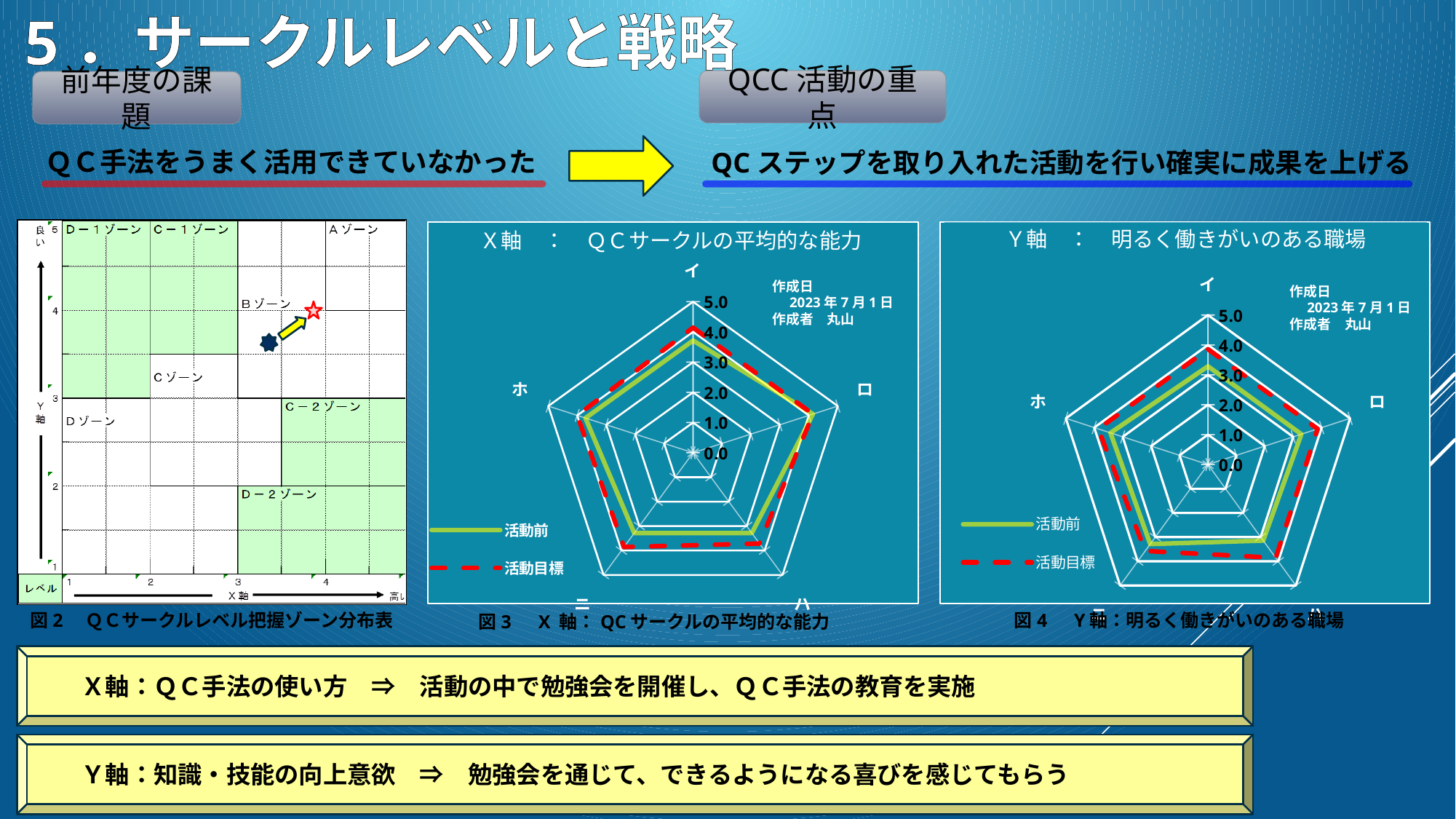
In 図4 (Y軸: 明るく働きがいのある職場), how many series does the legend list? 2 In 図3 (X軸: QCサークルの平均的な能力), is the 活動前 value for イ greater or less than 3.0? greater In 図4 (Y軸: 明るく働きがいのある職場), is the 活動前 value for イ greater or less than 4.0? less In 図4 (Y軸: 明るく働きがいのある職場), which series has the larger value for ハ, 活動前 or 活動目標? 活動目標 In 図3 (X軸: QCサークルの平均的な能力), what are the two series named in the legend? 活動前 and 活動目標 What kind of chart is 図4 (Y軸: 明るく働きがいのある職場)? Radar chart In 図3 (X軸: QCサークルの平均的な能力), how many axes (categories) does the radar chart have? 5 In 図3 (X軸: QCサークルの平均的な能力), which series is drawn as a red dashed line? 活動目標 In 図3 (X軸: QCサークルの平均的な能力), which series has the larger value for ホ, 活動前 or 活動目標? 活動目標 In 図3 (X軸: QCサークルの平均的な能力), is the 活動目標 value for ホ greater or less than 3.0? greater What kind of chart is 図3 (X軸: QCサークルの平均的な能力)? Radar chart